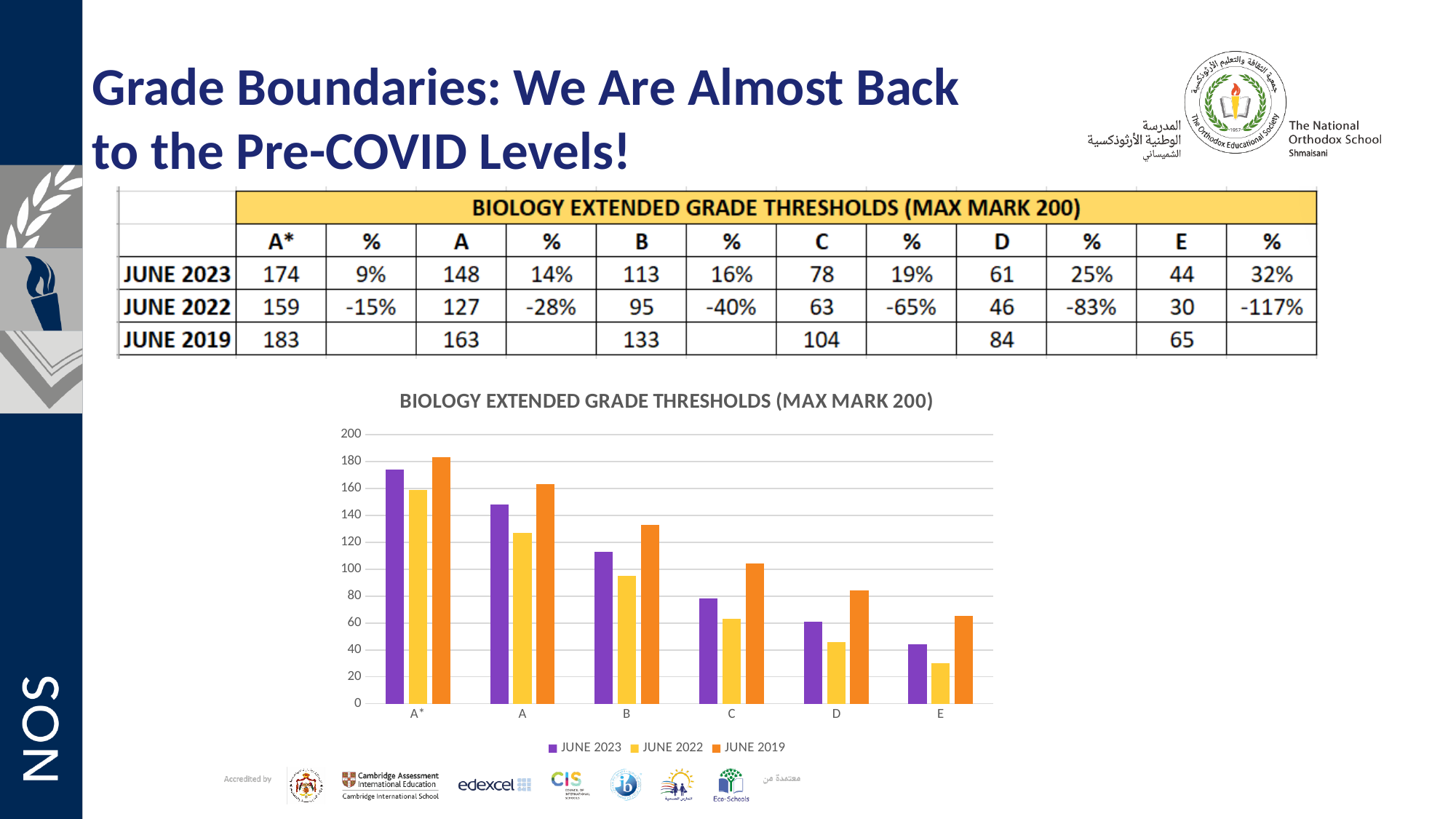
What is the JUNE 2019 threshold for grade C? 104 Do the JUNE 2023 values rise or fall moving from A* to E along the x axis? fall Which grade has the lowest JUNE 2022 threshold? E What is the JUNE 2022 threshold for grade E? 30 Which grade has the highest JUNE 2019 threshold? A* Is the JUNE 2022 value for grade A greater or less than 140? less What is the difference between the JUNE 2019 and JUNE 2023 thresholds for grade B? 20 For grade D, which series has the larger value, JUNE 2023 or JUNE 2022? JUNE 2023 What is the JUNE 2023 threshold for grade A*? 174 How many grade categories are shown on the x axis of the chart? 6 How many series does the chart legend list? 3 What type of chart is shown on the slide? bar chart